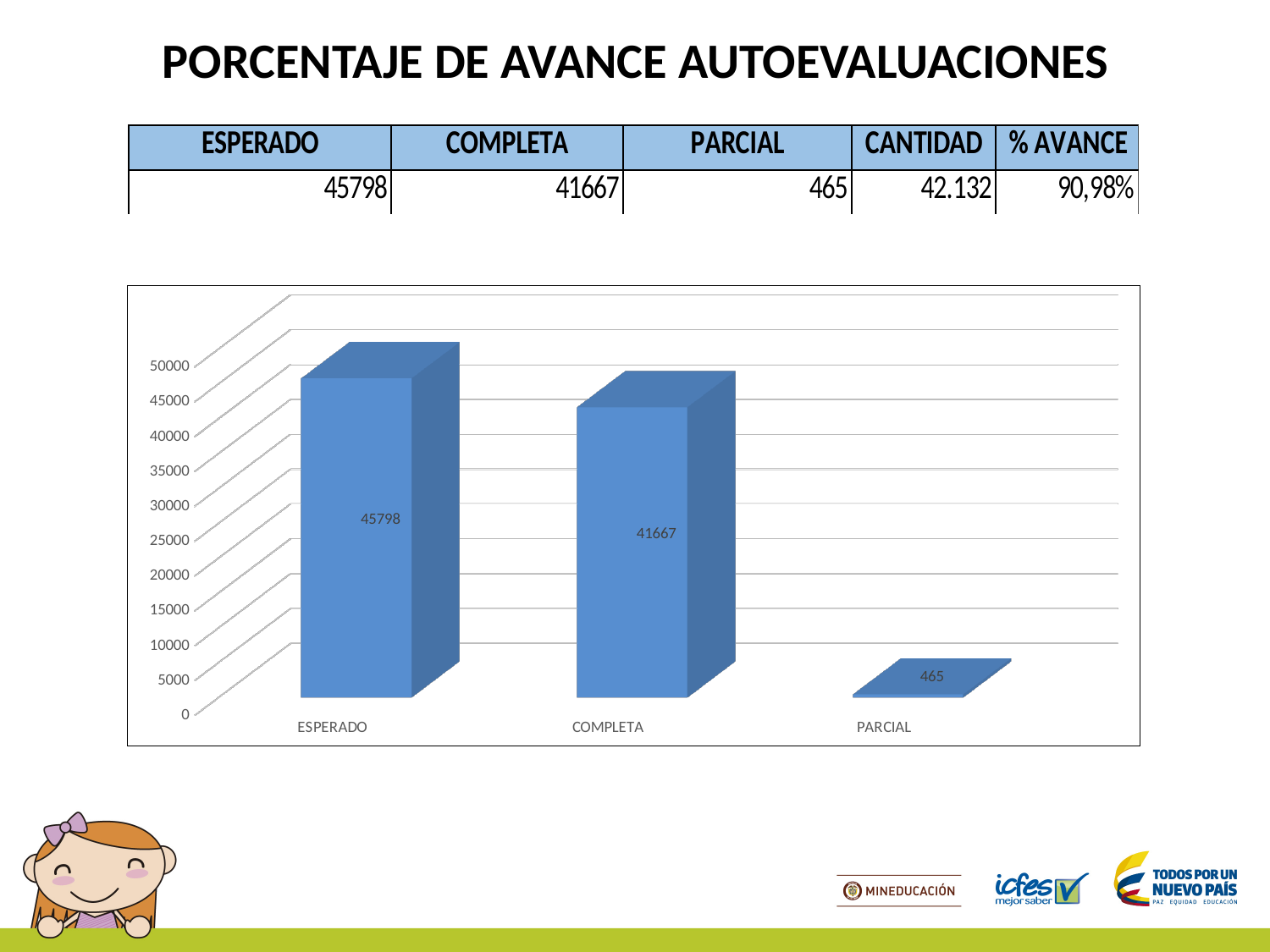
What is the value for ESPERADO in the chart? 45798 What is the difference between the values for ESPERADO and COMPLETA? 4131 Which category has the lowest value in the chart? PARCIAL What is the difference between the values for COMPLETA and PARCIAL? 41202 Do the values rise or fall from left to right along the x axis? fall Which category has the highest value in the chart? ESPERADO What kind of chart is shown on the slide? bar chart How many categories are shown on the x axis of the chart? 3 Is the value for COMPLETA greater or less than 40000? greater Which is larger, the value for COMPLETA or the value for PARCIAL? COMPLETA What is the value for PARCIAL in the chart? 465 What is the value for COMPLETA in the chart? 41667